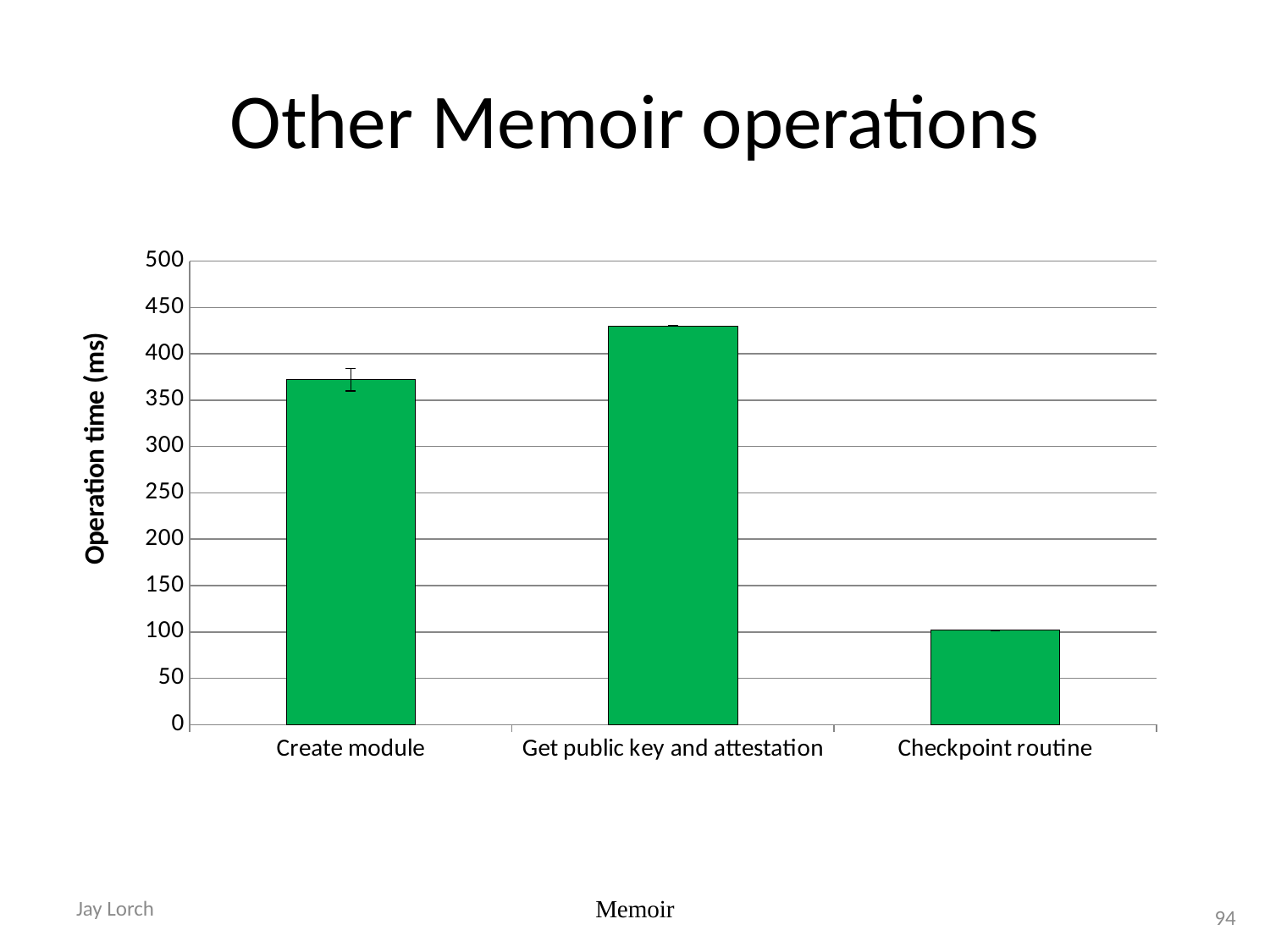
Which operation has the lowest operation time? Checkpoint routine What is the title of the slide? Other Memoir operations Is the value for Create module greater or less than 400? less What kind of chart is shown on the slide? bar chart Is the value for Get public key and attestation greater or less than 400? greater Which has a larger operation time, Create module or Checkpoint routine? Create module Which operation has the highest operation time? Get public key and attestation What is the title of the y axis? Operation time (ms) Is the value for Checkpoint routine greater or less than 150? less Which has a larger operation time, Create module or Get public key and attestation? Get public key and attestation How many categories are plotted on the chart? 3